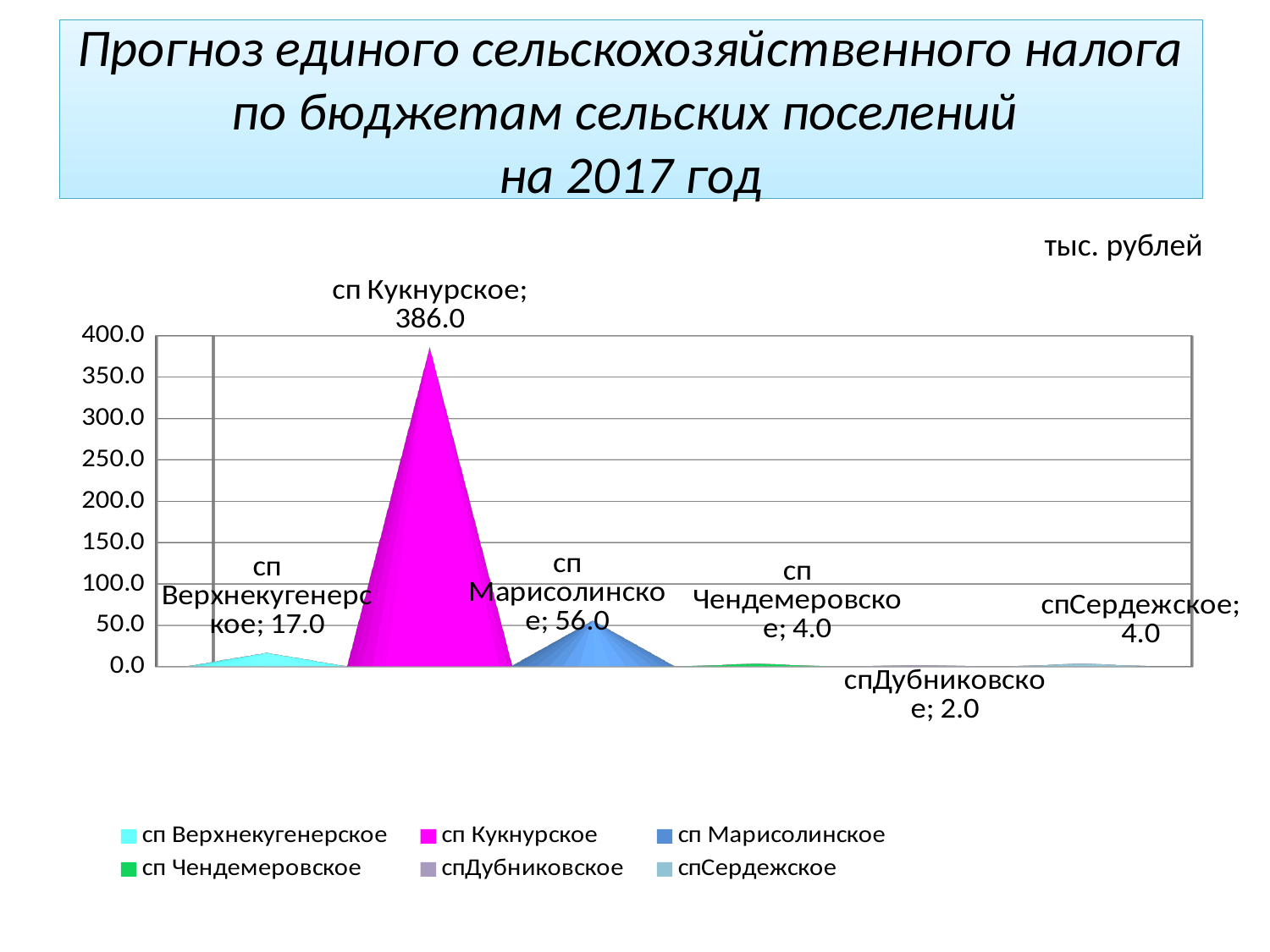
How many entries does the legend list? 6 What is the value for сп Кукнурское? 386.0 Which is larger, the value for сп Верхнекугенерское or сп Марисолинское? сп Марисолинское Which settlement has the highest forecast value? сп Кукнурское What is the value for спДубниковское? 2.0 What unit of measurement is indicated for the chart values? тыс. рублей Is the value for сп Кукнурское greater or less than 350.0? greater How many settlements are shown in the chart? 6 What is the value for сп Верхнекугенерское? 17.0 What is the value for сп Марисолинское? 56.0 What is the difference between the values for сп Кукнурское and сп Марисолинское? 330.0 Which settlement has the lowest forecast value? спДубниковское